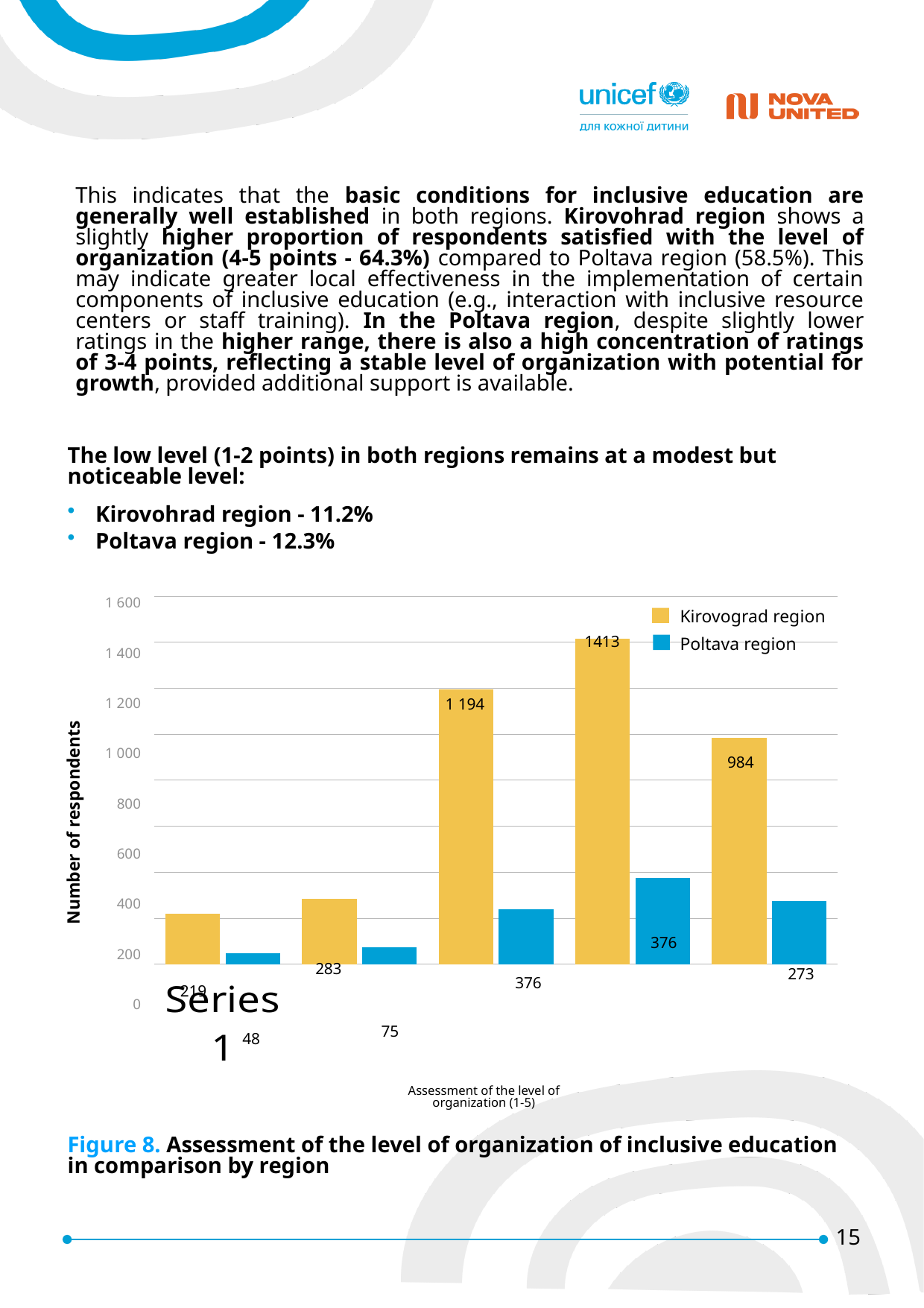
What kind of chart is shown on the slide? Bar chart In the fourth group of bars, what is the difference between the Kirovograd region value (1413) and the Poltava region value (376)? 1037 What is the highest value labelled for the Kirovograd region series? 1413 What are the two series named in the chart legend? Kirovograd region and Poltava region How many series does the chart legend list? 2 What is the title of the vertical axis of the chart? Number of respondents What is the lowest value labelled for the Poltava region series? 48 What is the lowest value labelled for the Kirovograd region series? 219 What value is labelled for the Kirovograd region in the third group of bars from the left? 1 194 How many groups of bars are plotted along the x axis? 5 What value is labelled for the Poltava region in the fifth (rightmost) group of bars? 273 In the rightmost group of bars, which series has the larger value, Kirovograd region or Poltava region? Kirovograd region